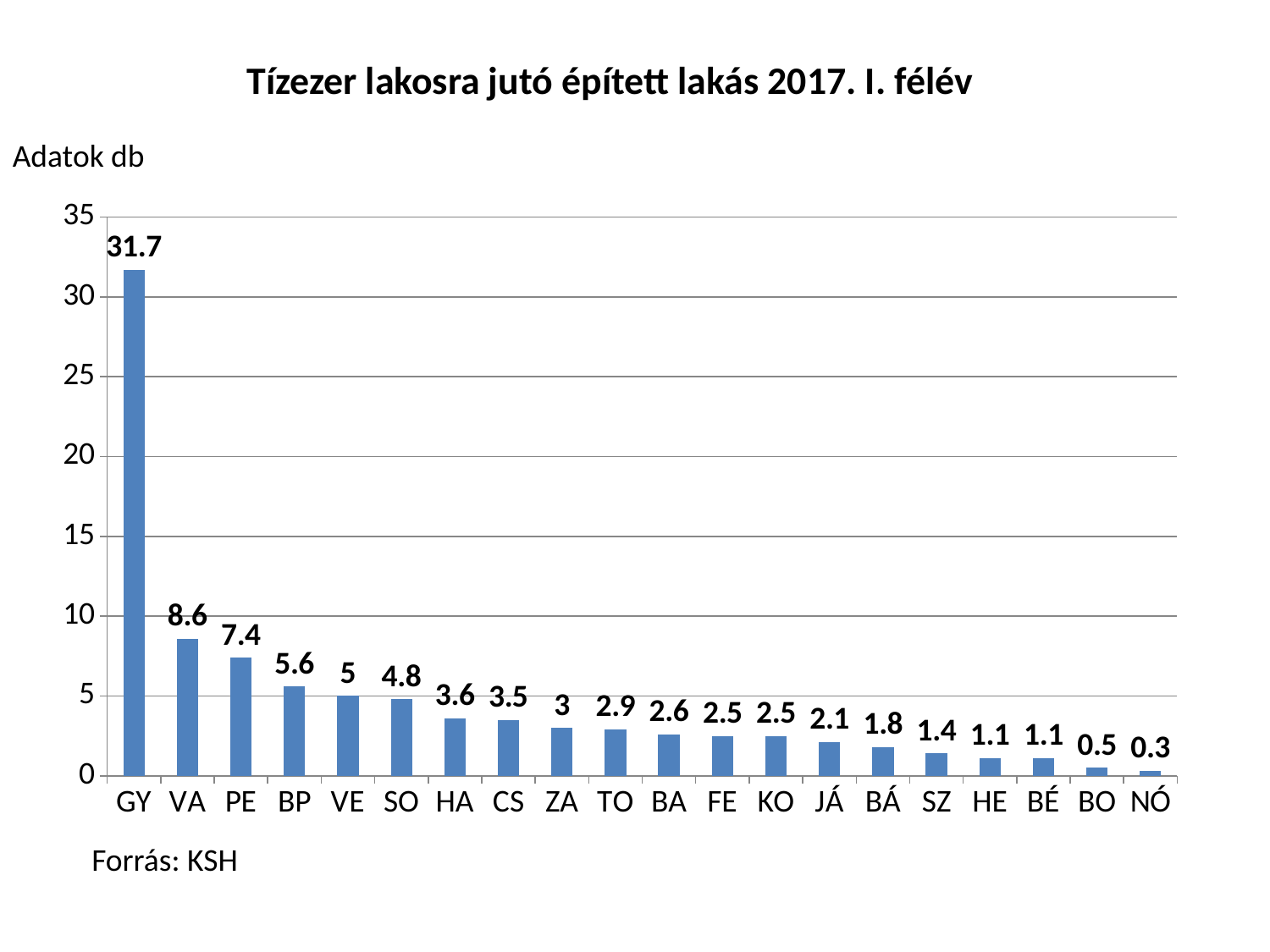
What kind of chart is shown on the slide? bar chart Is the value for VA greater or less than 10? less What is the value for BP? 5.6 What is the difference between the values for GY and VA? 23.1 Which is larger, the value for HA or the value for ZA? HA What is the value for SZ? 1.4 What is the title of the chart? Tízezer lakosra jutó épített lakás 2017. I. félév Which category has the lowest value? NÓ How many categories are shown on the x axis? 20 Which category has the highest value? GY What is the difference between the values for VA and PE? 1.2 What is the value for GY? 31.7